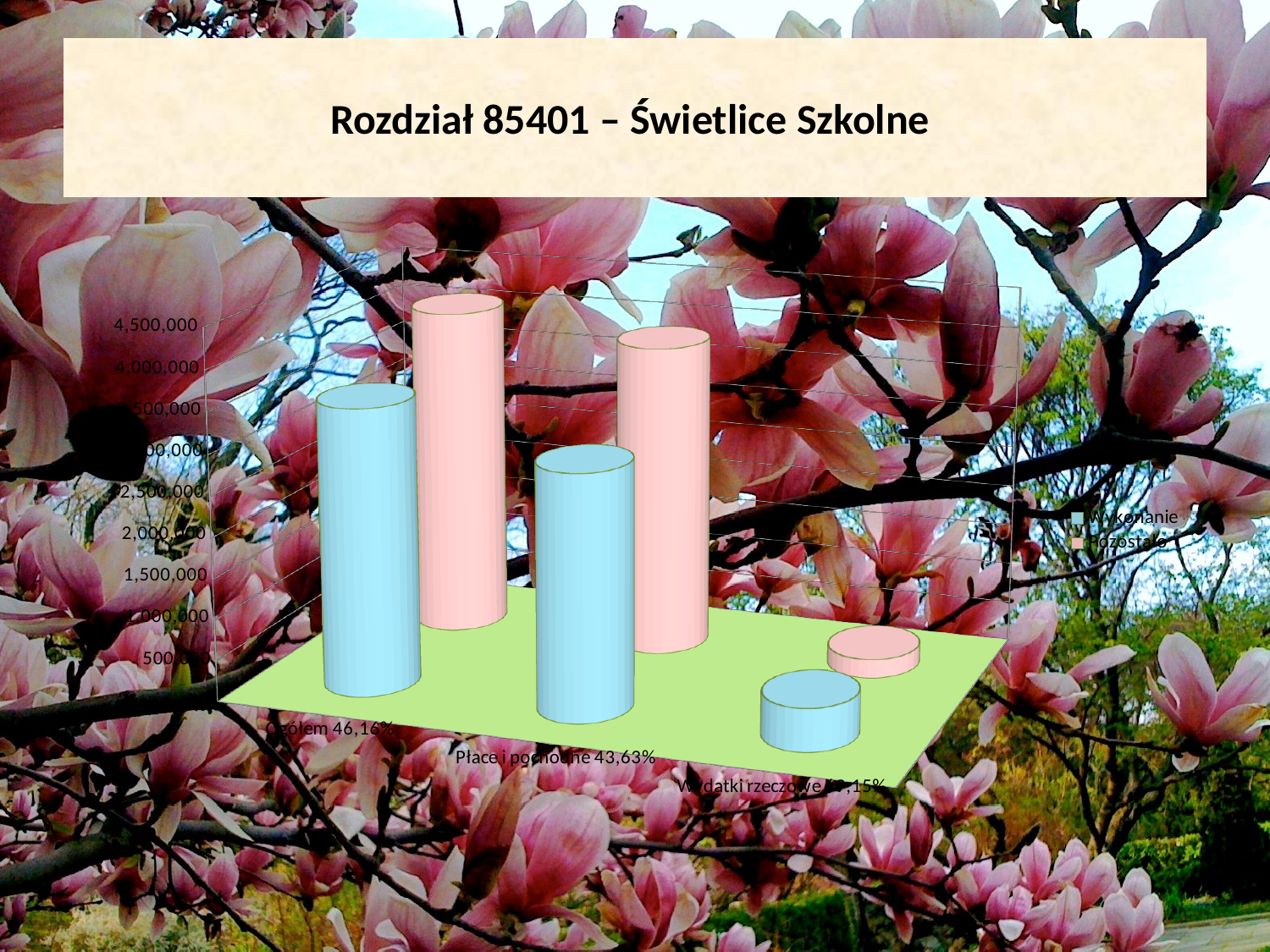
For Płace i pochodne 43,63%, which is larger: Wykonanie or Pozostało? Pozostało What is the title of the slide containing the chart? Rozdział 85401 – Świetlice Szkolne How many series does the legend list? 2 For Ogółem 46,16%, which is larger: Wykonanie or Pozostało? Pozostało Is the Pozostało value for Ogółem 46,16% greater or less than 3,000,000? greater Which category has the lowest Wykonanie value? Wydatki rzeczowe Do the Wykonanie values rise or fall from left to right across the categories? fall Which series is shown in pink in the chart? Pozostało What kind of chart is shown on the slide? bar chart How many categories are shown on the x axis of the chart? 3 Which category has the highest Pozostało value? Ogółem 46,16% Is the Wykonanie value for Wydatki rzeczowe greater or less than 1,000,000? less